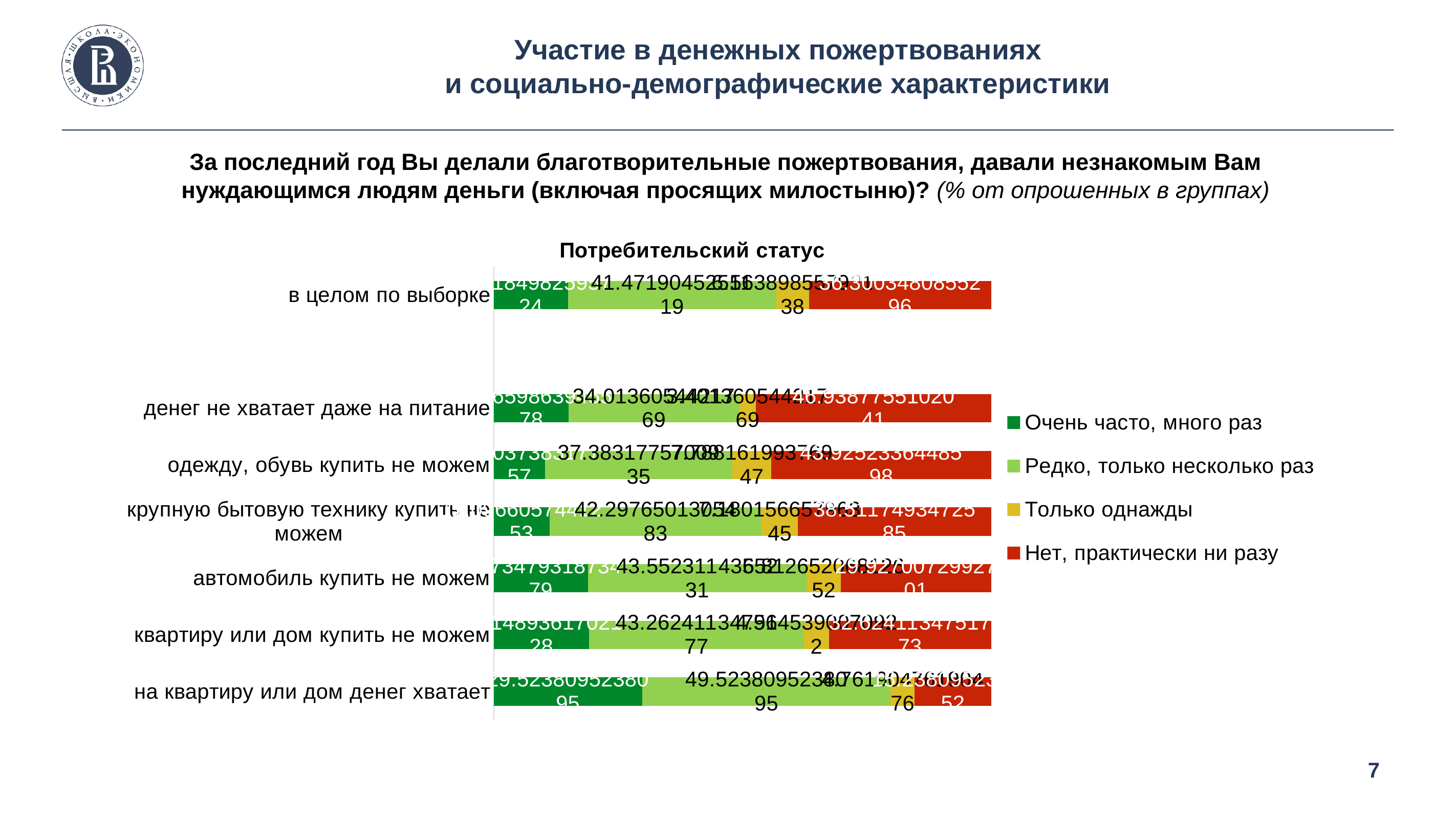
What kind of chart is shown on the slide? Stacked bar chart Which legend entry is shown in red? Нет, практически ни разу Is the 'Очень часто, много раз' segment larger for 'на квартиру или дом денег хватает' or for 'в целом по выборке'? на квартиру или дом денег хватает For which category is the 'Нет, практически ни разу' segment the smallest? на квартиру или дом денег хватает For which category is the 'Очень часто, много раз' segment the largest? на квартиру или дом денег хватает Is the 'Нет, практически ни разу' segment larger for 'денег не хватает даже на питание' or for 'на квартиру или дом денег хватает'? денег не хватает даже на питание For which category is the 'Нет, практически ни разу' segment the largest? денег не хватает даже на питание How many categories (bars) are plotted in the chart? 7 What is the title of the chart? Потребительский статус Moving down the bars from 'денег не хватает даже на питание' to 'на квартиру или дом денег хватает', does the 'Очень часто, много раз' segment get larger or smaller? larger Moving down the bars from 'денег не хватает даже на питание' to 'на квартиру или дом денег хватает', does the 'Нет, практически ни разу' segment get larger or smaller? smaller How many series does the legend list? 4